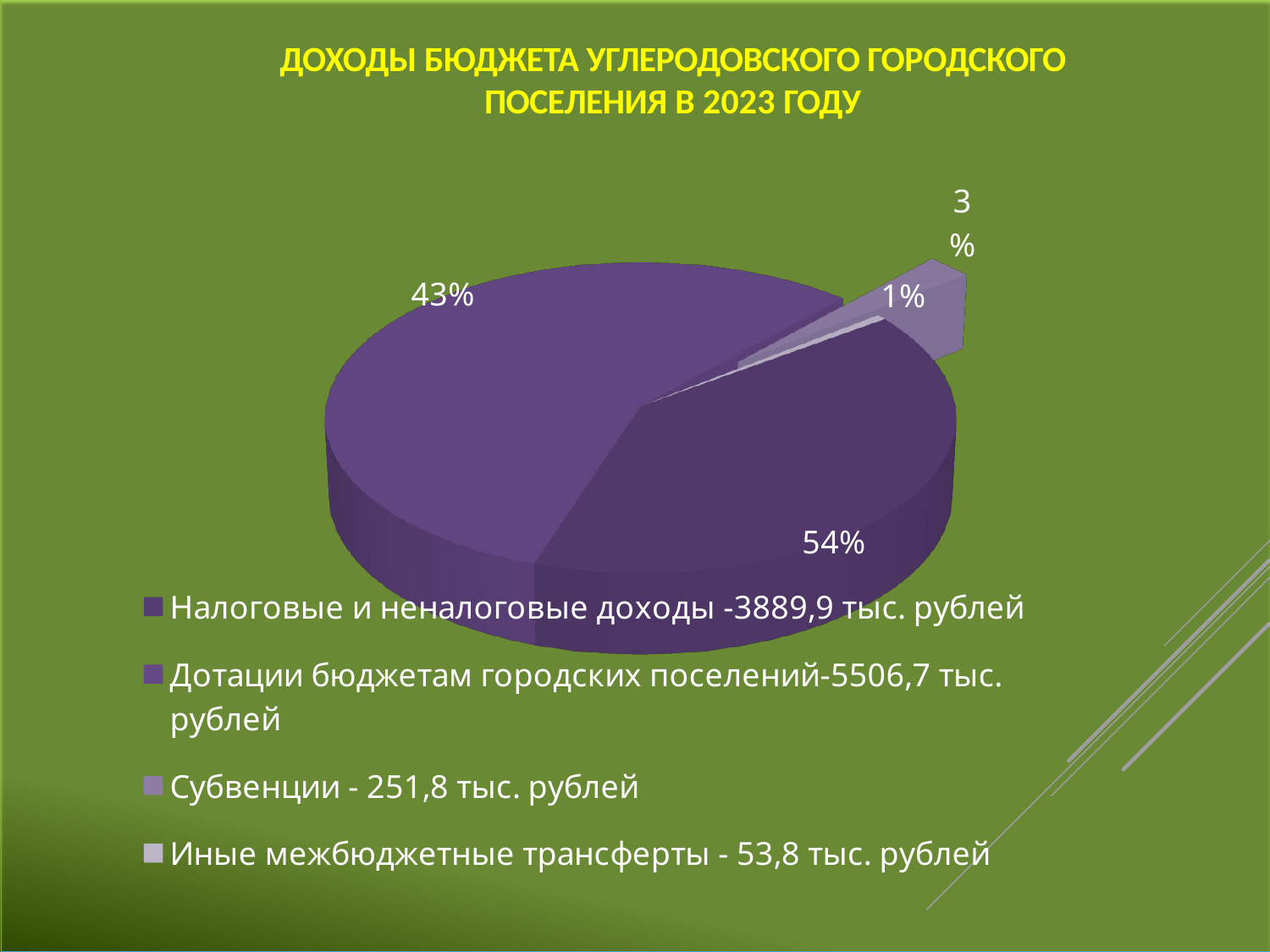
What is the difference in percentage points between the shares of "Дотации бюджетам городских поселений" and "Налоговые и неналоговые доходы"? 11 Which category has the largest share of the pie? Дотации бюджетам городских поселений What share of the pie does "Дотации бюджетам городских поселений" represent? 54% According to the legend, what amount in тыс. рублей corresponds to "Субвенции"? 251,8 тыс. рублей What share of the pie does "Налоговые и неналоговые доходы" represent? 43% What share of the pie does "Субвенции" represent? 3% How many slices does the pie chart have? 4 Which is larger: the share of "Субвенции" or the share of "Иные межбюджетные трансферты"? Субвенции Which category has the smallest share of the pie? Иные межбюджетные трансферты How many entries does the legend list? 4 What type of chart is shown on the slide? Pie chart